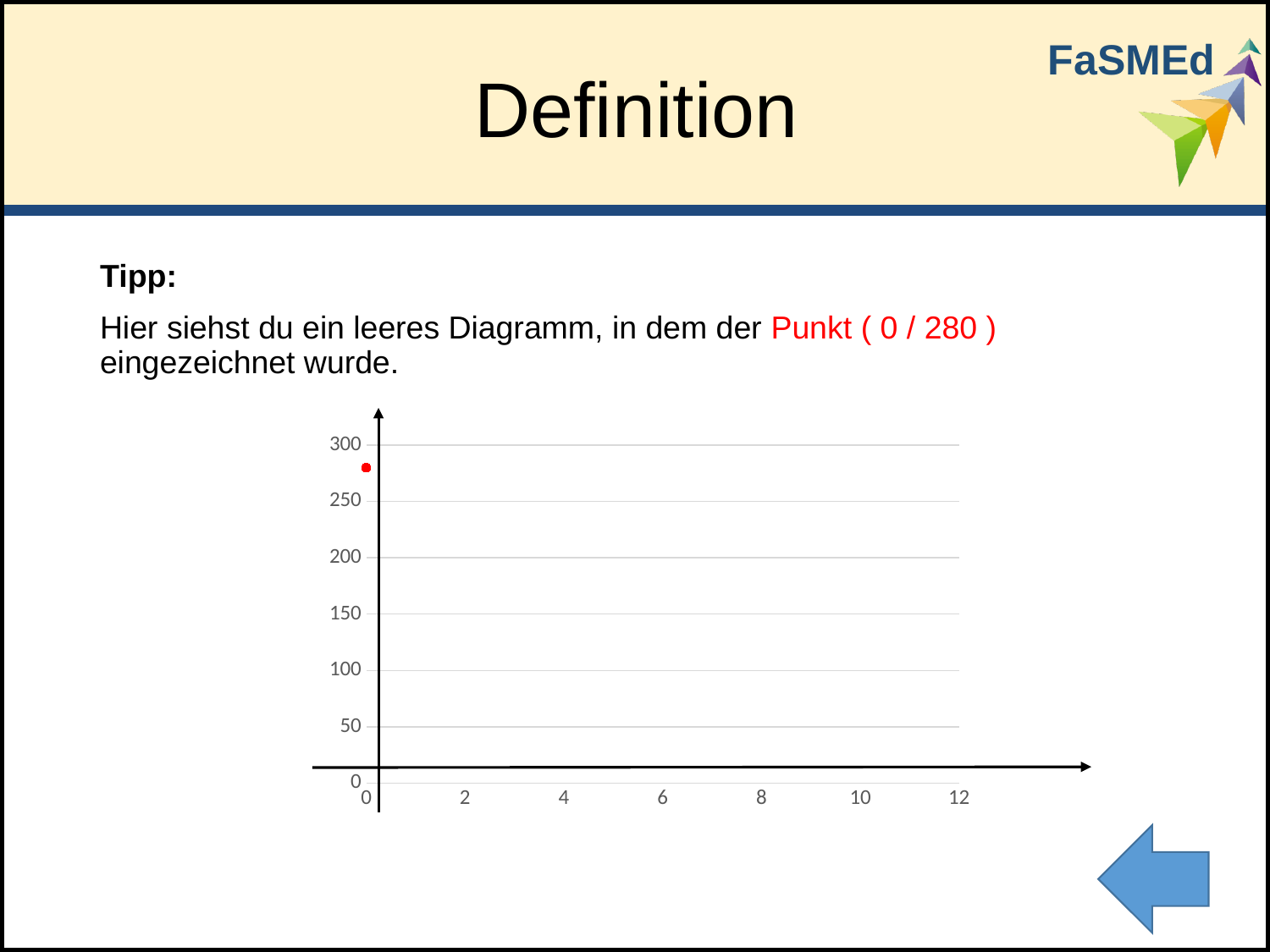
What colour is the plotted point? red What is the x-value of the plotted point? 0 What kind of chart is shown on the slide? scatter chart Is the y-value of the plotted point greater or less than 250? greater What is the y-value of the plotted point? 280 How many data points are plotted in the chart? 1 Is the y-value of the plotted point greater or less than 300? less What is the highest tick label on the y-axis? 300 What is the highest tick label on the x-axis? 12